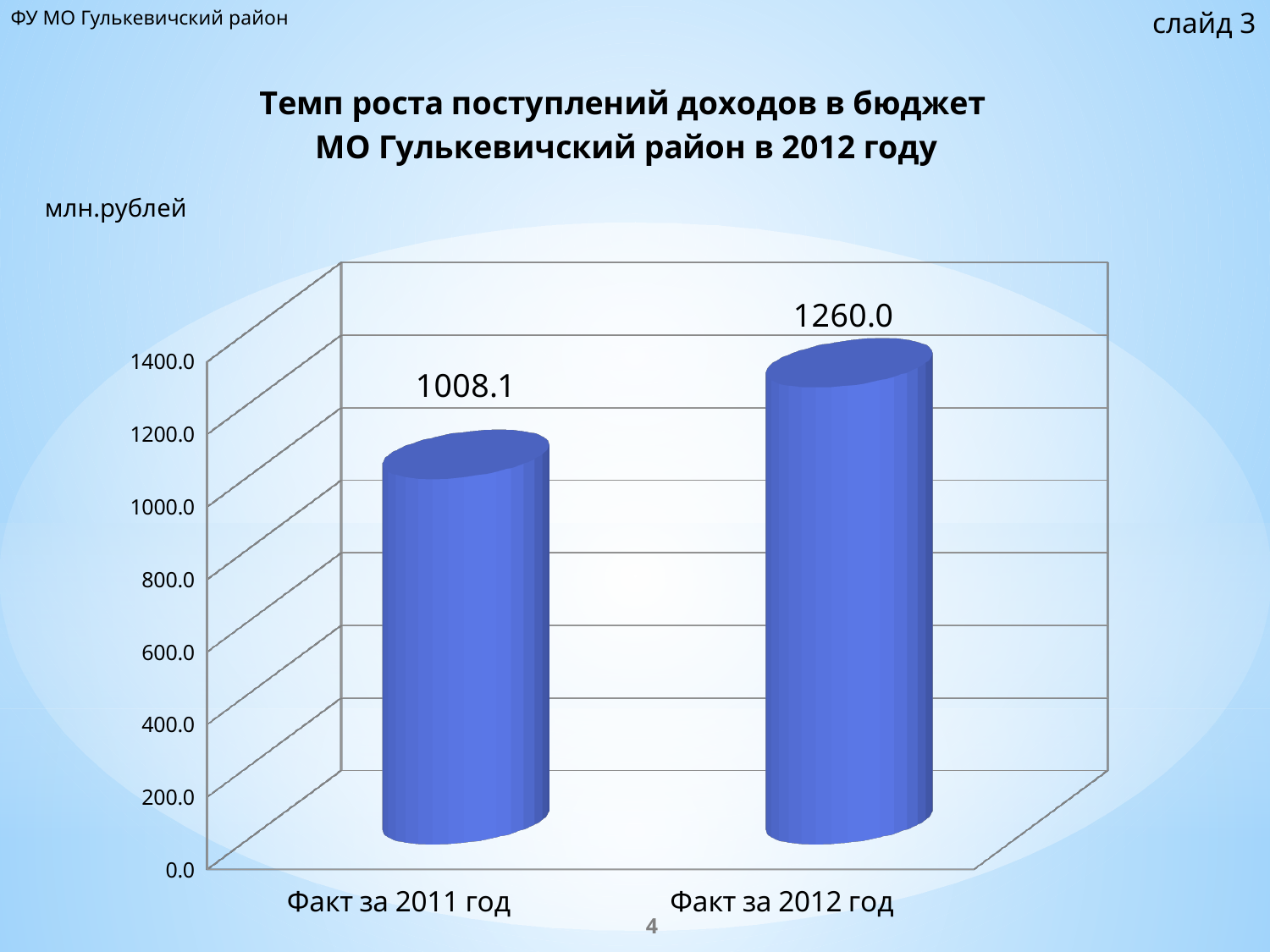
Is the value for Факт за 2012 год greater or less than 1200.0? greater How many categories are shown on the chart? 2 What unit is indicated for the values on the chart? млн.рублей What is the value for Факт за 2011 год? 1008.1 What is the value for Факт за 2012 год? 1260.0 What kind of chart is shown on the slide? bar chart Which category has the lowest value? Факт за 2011 год Which is larger, the value for Факт за 2011 год or Факт за 2012 год? Факт за 2012 год Is the value for Факт за 2011 год greater or less than 1200.0? less Which category has the highest value? Факт за 2012 год Do the values rise or fall from Факт за 2011 год to Факт за 2012 год? rise What is the difference between the values for Факт за 2012 год and Факт за 2011 год? 251.9